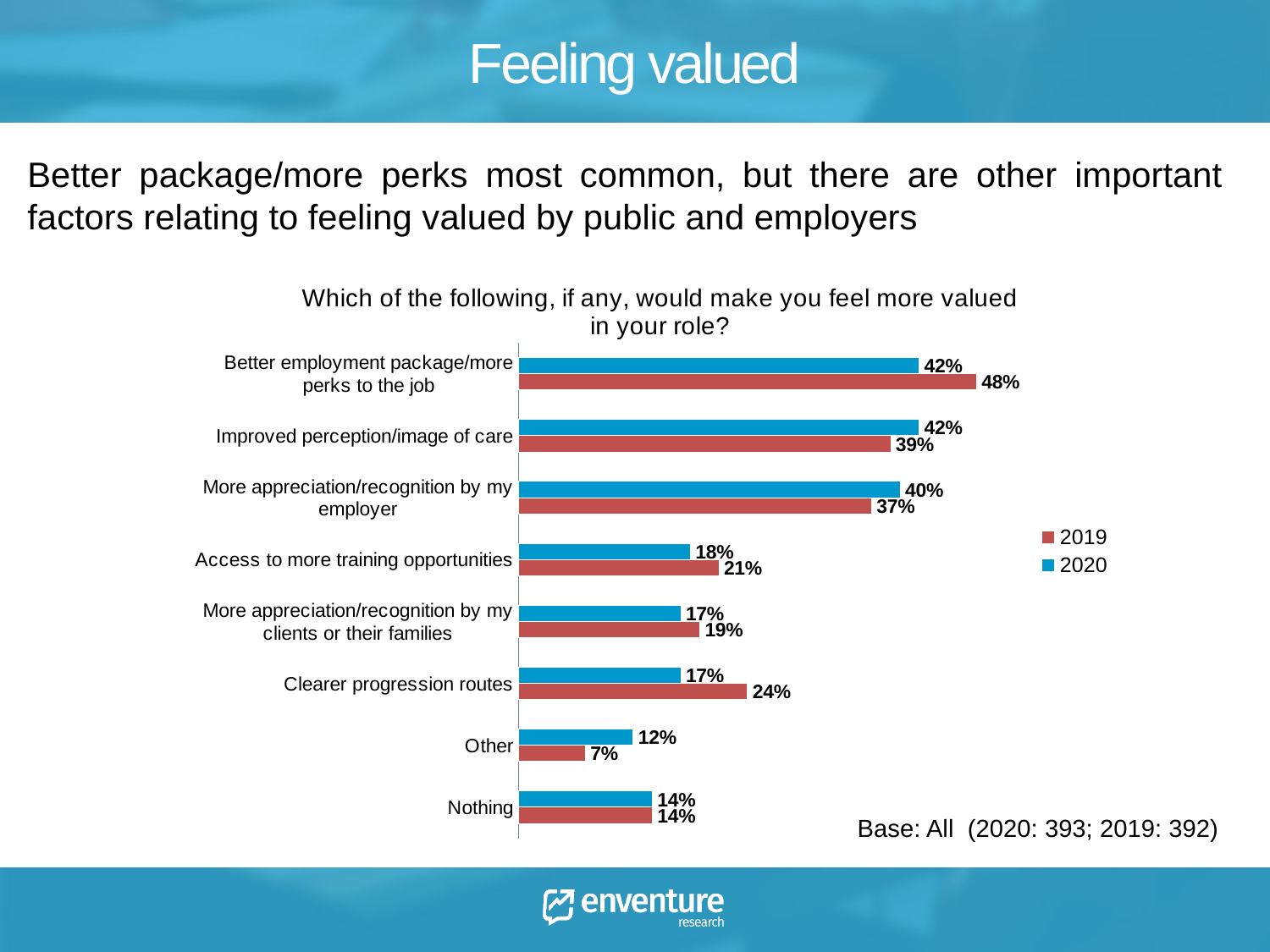
Which category has the lowest 2019 value? Other What is the 2019 value for 'Clearer progression routes'? 24% How many categories are shown on the chart? 8 What is the 2019 value for 'Other'? 7% What is the difference between the 2019 and 2020 values for 'Clearer progression routes'? 7% Which is larger for 'Improved perception/image of care': the 2019 value or the 2020 value? 2020 What is the 2020 value for 'Better employment package/more perks to the job'? 42% What is the 2020 value for 'Nothing'? 14% What kind of chart is shown on the slide? Bar chart How many series does the legend list? 2 Which category has the highest 2019 value? Better employment package/more perks to the job Which colour represents the 2020 series in the legend? Blue